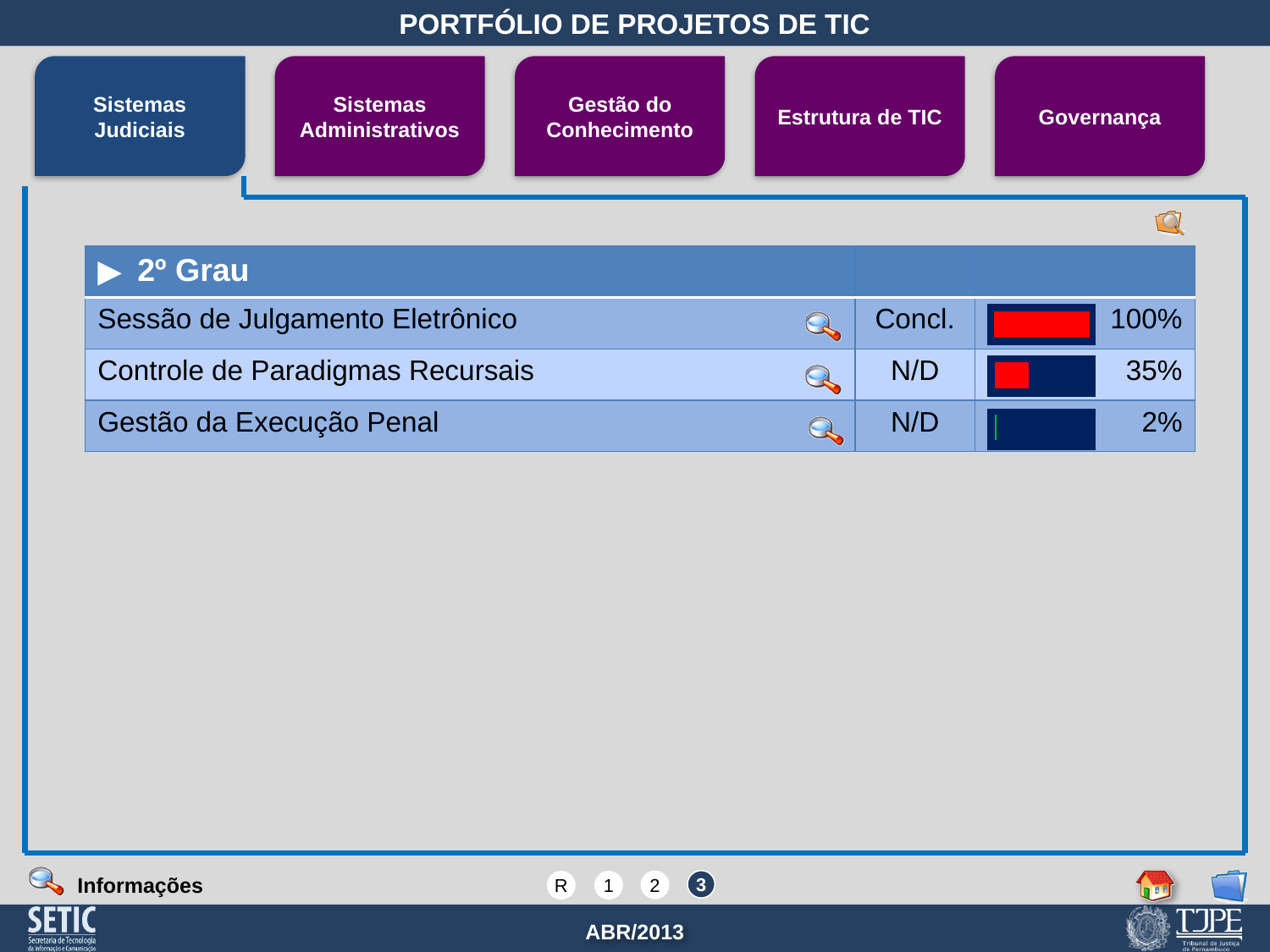
What is the heading of the group of projects shown? 2º Grau What is the difference in completion percentage between Sessão de Julgamento Eletrônico and Controle de Paradigmas Recursais? 65% Which project has the lowest completion percentage? Gestão da Execução Penal What is the completion percentage shown for Controle de Paradigmas Recursais? 35% Which project has the highest completion percentage? Sessão de Julgamento Eletrônico How many projects are listed under 2º Grau? 3 What kind of chart is used to show the completion of each project? Bar chart What is the completion percentage shown for Gestão da Execução Penal? 2% What is the difference in completion percentage between Controle de Paradigmas Recursais and Gestão da Execução Penal? 33% Which has a higher completion percentage, Controle de Paradigmas Recursais or Gestão da Execução Penal? Controle de Paradigmas Recursais What is the completion percentage shown for Sessão de Julgamento Eletrônico? 100% What status is shown for Sessão de Julgamento Eletrônico? Concl.